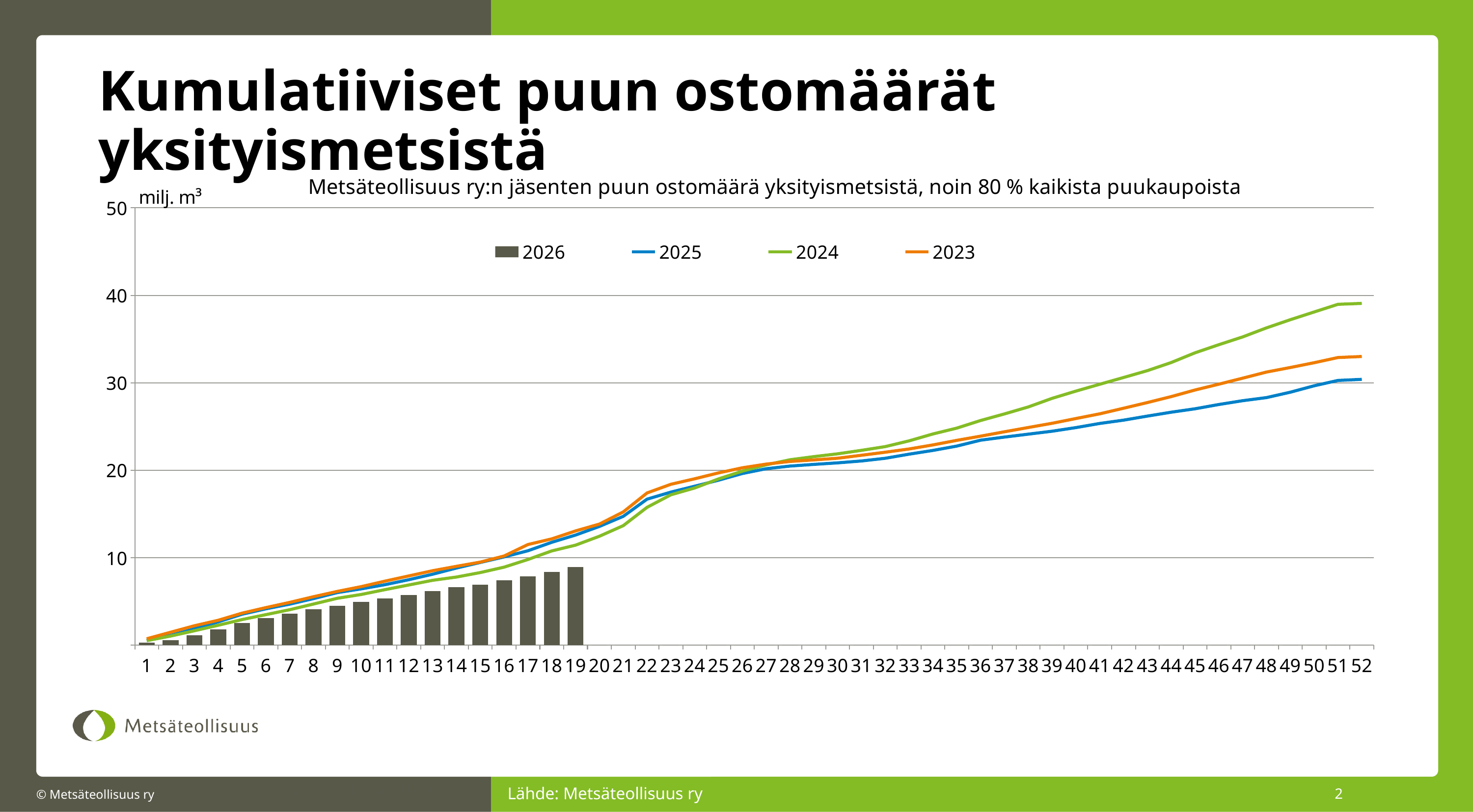
How many series does the chart legend list? 4 Which series is plotted as bars rather than a line? 2026 What kind of chart is shown on the slide? A combined bar and line chart At week 52, which is larger: the value for 2023 or the value for 2025? 2023 Is the value for 2026 at week 19 greater or less than 10? less Do the values for the 2025 series rise or fall along the x axis? rise What unit is shown on the y axis of the chart? milj. m³ Which series has the highest value at week 52? 2024 How many weeks (x-axis categories) does the chart cover? 52 Up to which week are bars plotted for the 2026 series? 19 Which series has the lowest value at week 52? 2025 Is the value for 2024 at week 52 greater or less than 30? greater